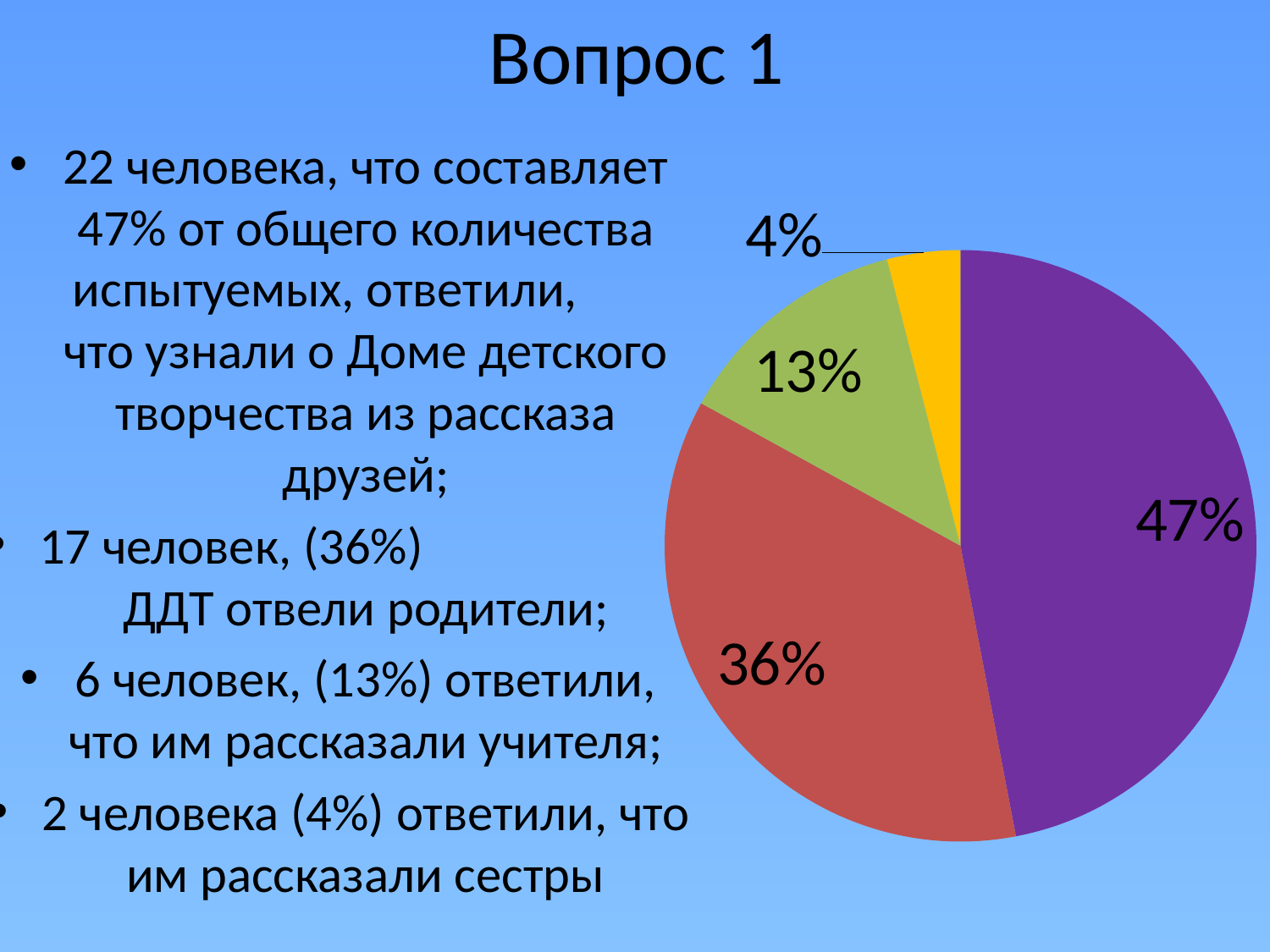
What percentage is shown on the purple slice of the pie chart? 47% How many slices does the pie chart have? 4 What kind of chart is shown on the slide? pie chart By how many percentage points does the purple slice exceed the red slice? 11 What percentage is shown on the yellow slice of the pie chart? 4% What is the value of the largest slice of the pie chart? 47% Which slice is larger, the red one or the green one? red What percentage is shown on the red slice of the pie chart? 36% What is the value of the smallest slice of the pie chart? 4% What colour is the largest slice of the pie chart? purple What percentage is shown on the green slice of the pie chart? 13% What share of the pie does the green slice represent? 13%